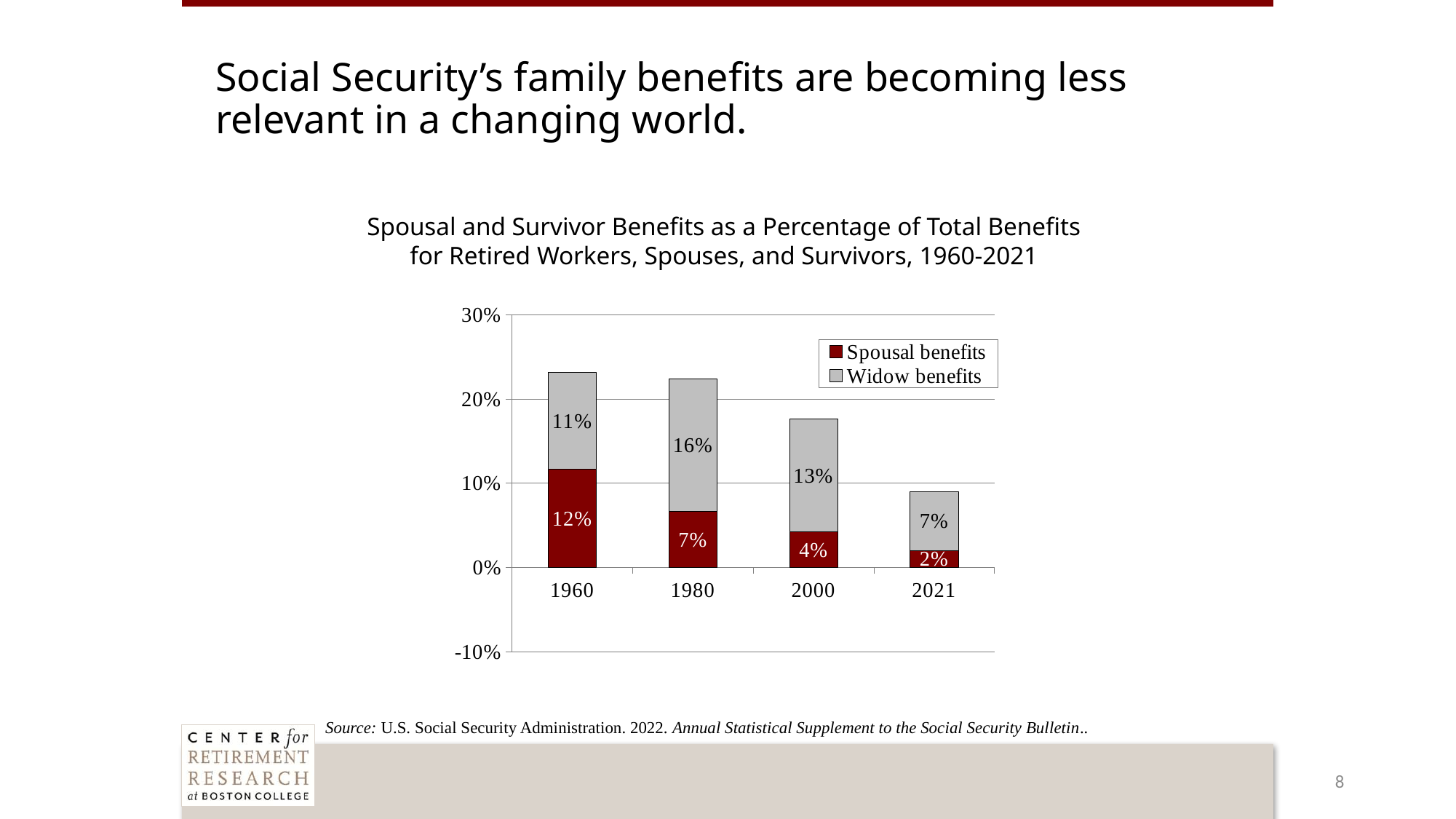
What is the Widow benefits value for 2000? 13% What is the Spousal benefits value for 1960? 12% What is the difference between the Spousal benefits values for 1960 and 2021? 10% What is the Widow benefits value for 1980? 16% How many series does the legend list? 2 What kind of chart is shown on the slide? Stacked bar chart Which is larger, the Widow benefits value for 2000 or for 2021? 2000 How many years are shown on the x axis? 4 Which year has the highest Widow benefits value? 1980 What is the Spousal benefits value for 2021? 2% Which year has the lowest Spousal benefits value? 2021 What is the total of the stacked bar for 2021? 9%